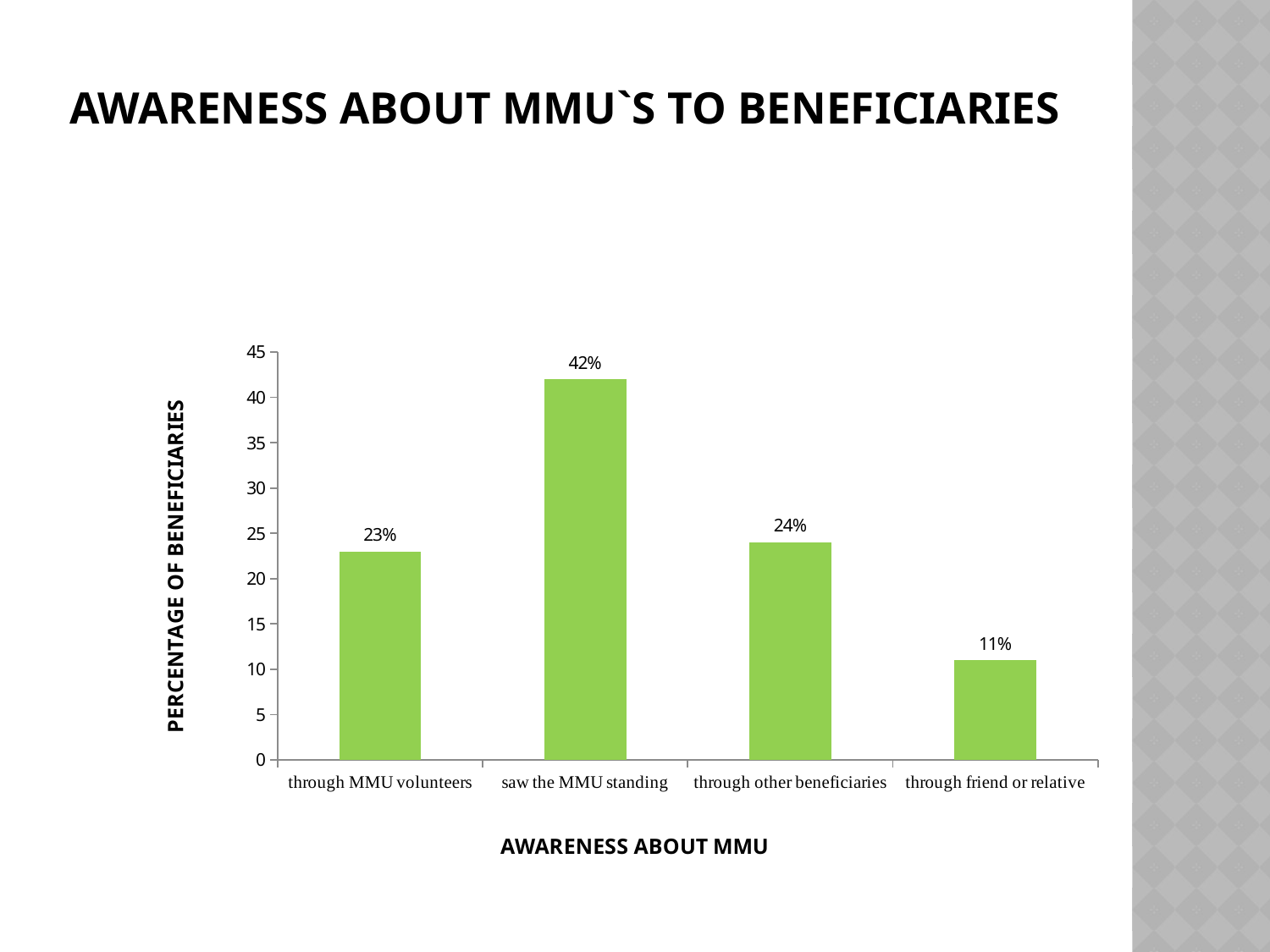
What kind of chart is shown on the slide? bar chart What is the difference in percentage points between 'saw the MMU standing' and 'through other beneficiaries'? 18 What is the difference in percentage points between 'through MMU volunteers' and 'through friend or relative'? 12 Which is larger: the percentage for 'through other beneficiaries' or for 'through friend or relative'? through other beneficiaries What percentage of beneficiaries became aware of the MMU through MMU volunteers? 23% What percentage of beneficiaries became aware of the MMU by seeing the MMU standing? 42% Is the value for 'saw the MMU standing' greater or less than 40? greater How many awareness source categories are shown on the x axis? 4 Which awareness source has the highest percentage of beneficiaries? saw the MMU standing What is the label of the vertical axis? PERCENTAGE OF BENEFICIARIES Which awareness source has the lowest percentage of beneficiaries? through friend or relative What percentage of beneficiaries became aware of the MMU through a friend or relative? 11%